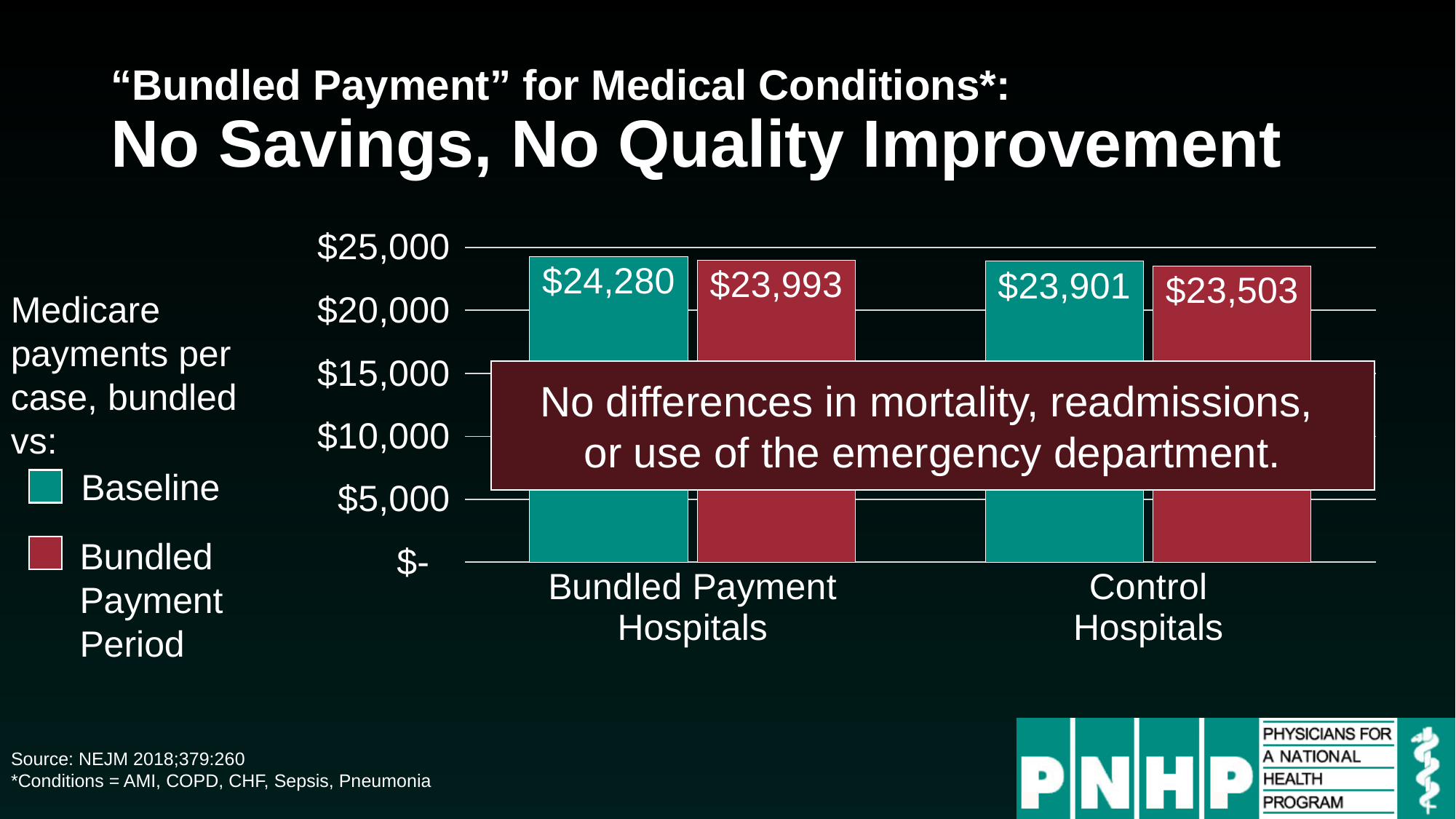
What is the Baseline value for Control Hospitals? $23,901 How many hospital groups (categories) are shown on the x axis? 2 Which bar has the highest value on the chart? Baseline, Bundled Payment Hospitals Which is larger: the Baseline value for Control Hospitals or the Bundled Payment Period value for Bundled Payment Hospitals? Bundled Payment Period value for Bundled Payment Hospitals What is the difference between the Baseline and Bundled Payment Period values for Control Hospitals? $398 What is the difference between the Baseline and Bundled Payment Period values for Bundled Payment Hospitals? $287 What is the Baseline value for Bundled Payment Hospitals? $24,280 How many series does the legend list? 2 What kind of chart is shown on the slide? Bar chart Which bar has the lowest value on the chart? Bundled Payment Period, Control Hospitals What is the Bundled Payment Period value for Bundled Payment Hospitals? $23,993 What is the Bundled Payment Period value for Control Hospitals? $23,503